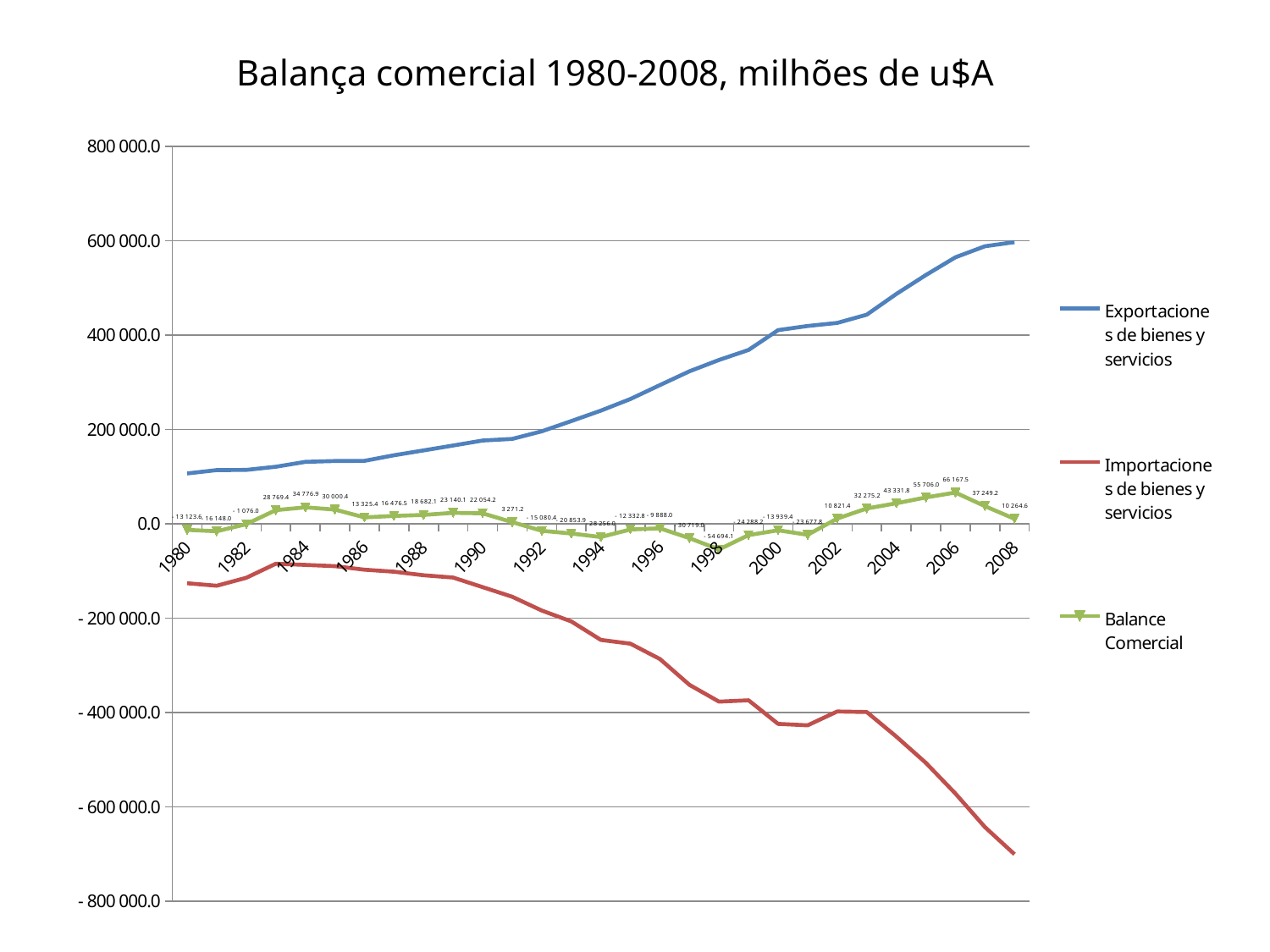
What is the title of the chart? Balança comercial 1980-2008, milhões de u$A What is the Balance Comercial value for 2006? 66 167.5 Is the value of Importaciones de bienes y servicios in 2008 greater or less than -600 000.0? less In which year does the Balance Comercial series reach its highest value? 2006 How many series does the legend list? 3 In which year does the Balance Comercial series reach its lowest value? 1998 Do the values of Exportaciones de bienes y servicios rise or fall from 1980 to 2008? rise Is the value of Exportaciones de bienes y servicios in 2008 greater or less than 400 000.0? greater What is the Balance Comercial value for 1998? - 54 694.1 Which is larger for Balance Comercial: the value in 2006 or the value in 2007? 2006 What kind of chart is shown on the slide? line chart What is the difference between the Balance Comercial values for 2005 and 2004? 12 374.2